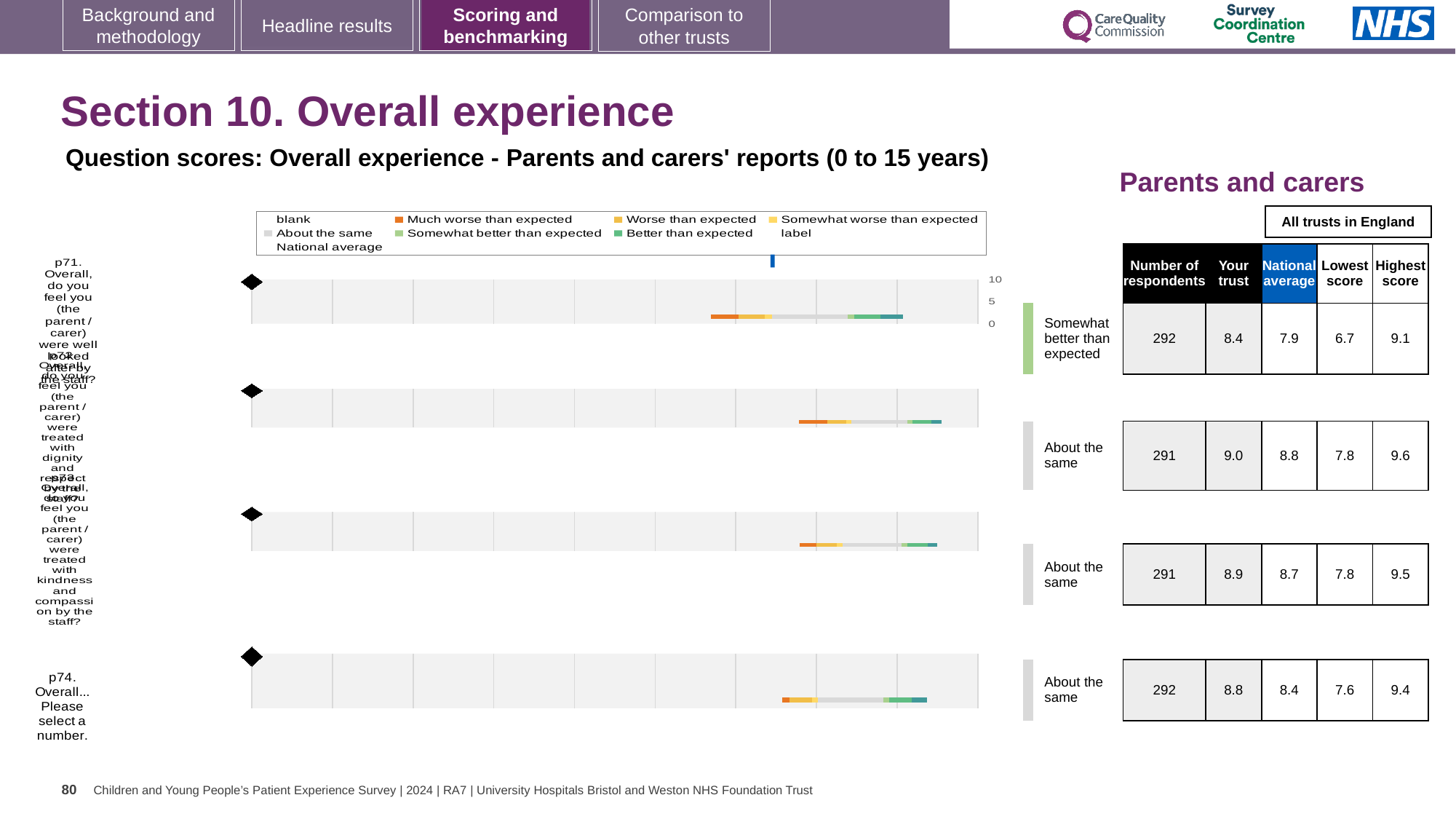
What kind of chart is used to show the question scores for Overall experience? bar chart What is the highest score across all trusts in England for p74 (Overall... Please select a number)? 9.4 How many respondents are listed for p72 (treated with dignity and respect)? 291 For p73 (treated with kindness and compassion), which is larger: the 'Your trust' score or the national average? Your trust In the chart legend, which colour represents 'Much worse than expected'? orange What is the difference between the 'Your trust' score and the national average for p71? 0.5 How many questions (rows) are plotted in the Overall experience chart? 4 What is the lowest score across all trusts in England for p72? 7.8 Which question has the highest 'Your trust' score? p72 What is the 'Your trust' score for p71 (were you, the parent/carer, well looked after by the staff)? 8.4 What is the highest tick value shown on the chart's score axis? 10 What benchmark category is shown for p71? Somewhat better than expected